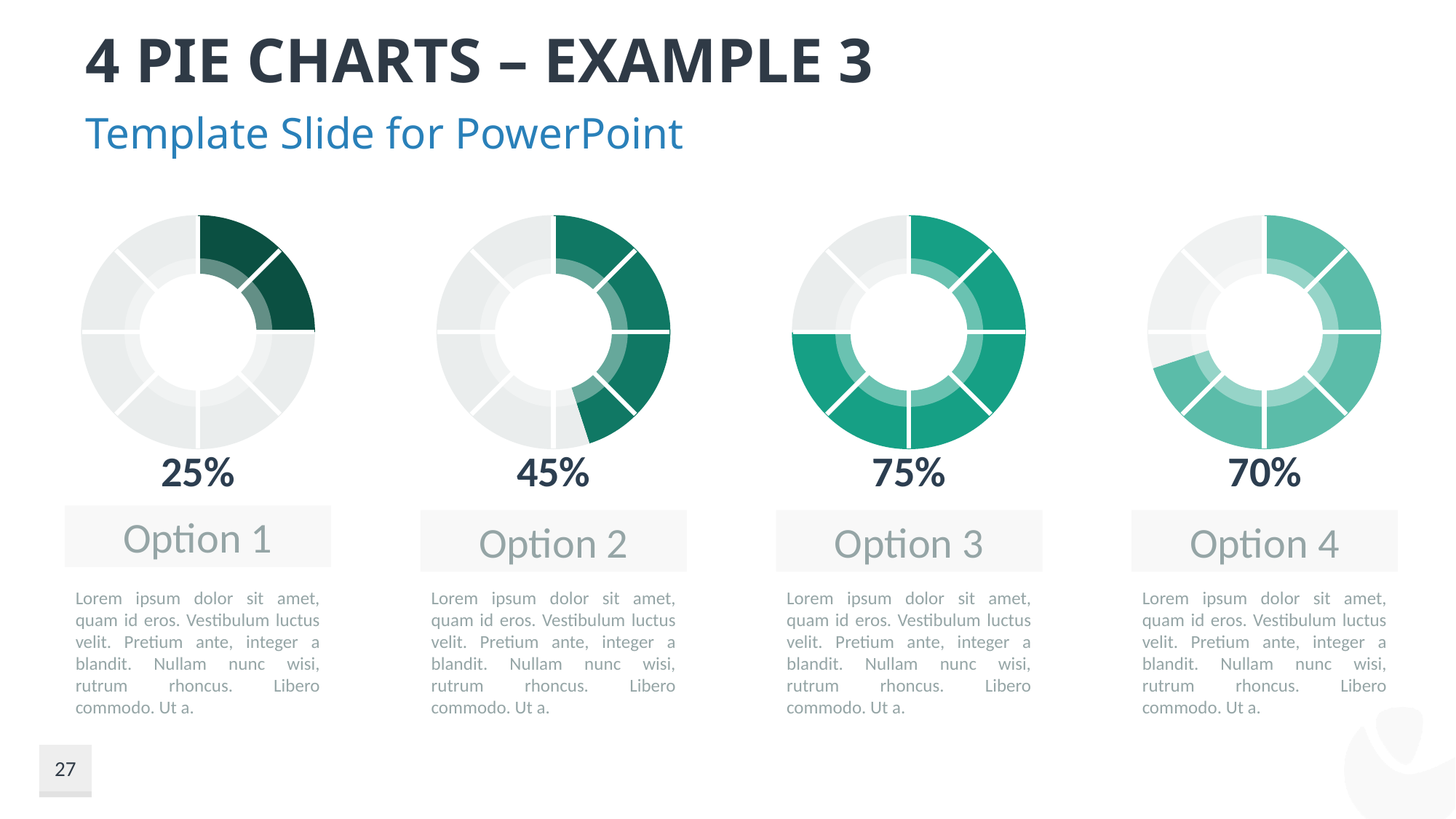
Which is larger, the percentage for Option 2 or the percentage for Option 4? Option 4 What kind of chart is used for each option on the slide? Pie chart (donut) Which option has the lowest percentage? Option 1 Which option has the highest percentage? Option 3 How many pie charts are shown on the slide? 4 What is the difference between the percentages for Option 3 and Option 4? 5% What percentage is shown for the Option 4 chart? 70% What is the title of the slide? 4 PIE CHARTS – EXAMPLE 3 What percentage is shown for the Option 3 chart? 75% What is the difference between the percentages for Option 2 and Option 1? 20% What percentage is shown for the Option 2 chart? 45% What percentage is shown for the Option 1 chart? 25%